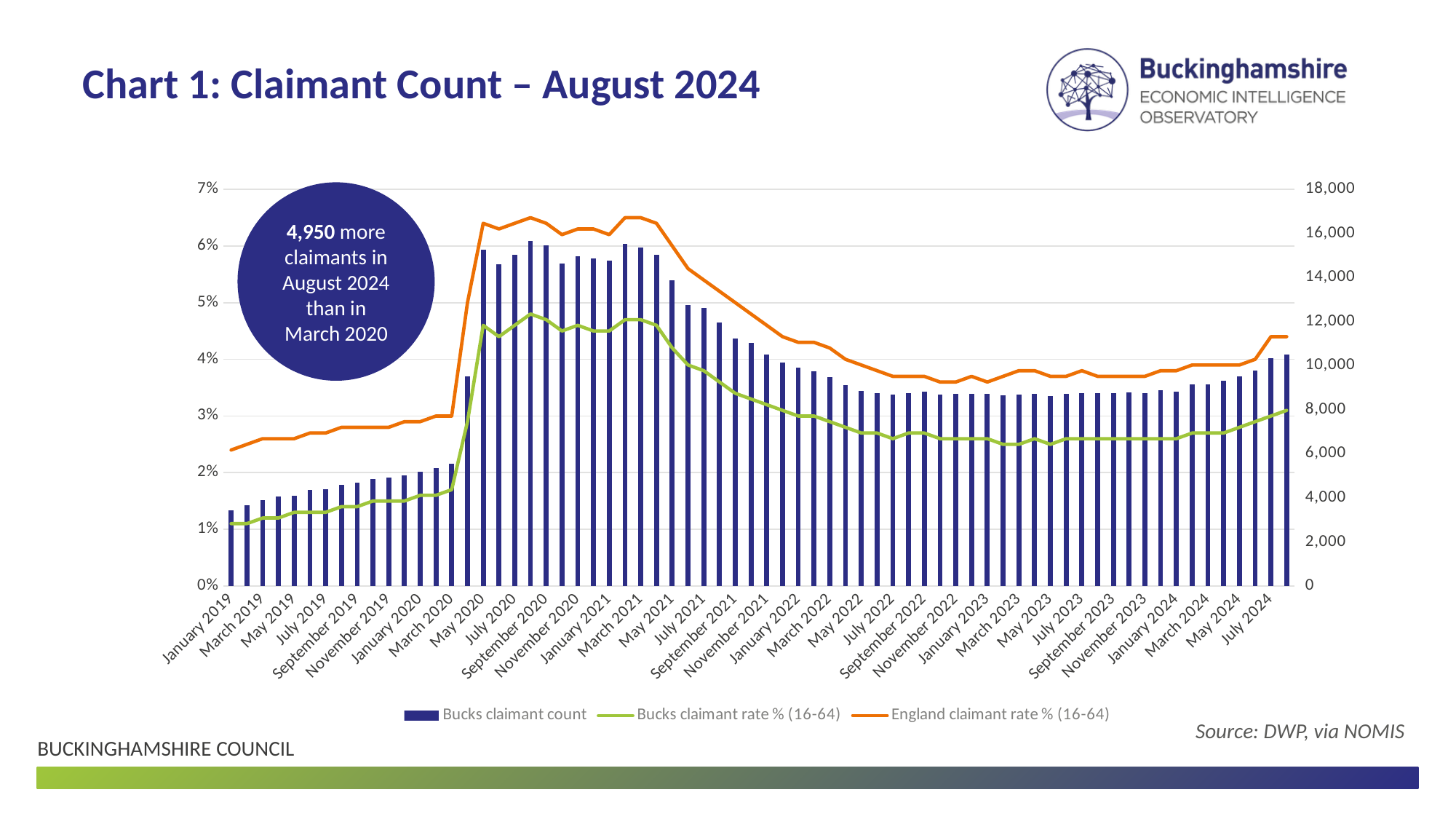
Is the Bucks claimant count for January 2019 greater or less than 4,000? less Is the Bucks claimant count for July 2024 greater or less than 8,000? greater Does the Bucks claimant count rise or fall between May 2021 and July 2022? fall In January 2021, which is higher: the England claimant rate % (16-64) or the Bucks claimant rate % (16-64)? England claimant rate % (16-64) Is the England claimant rate % (16-64) for January 2019 greater or less than 3%? less Does the Bucks claimant count rise or fall between January 2019 and March 2020? rise Which series is plotted as bars? Bucks claimant count How many series does the legend list? 3 According to the callout, how many more claimants were there in August 2024 than in March 2020? 4,950 What kind of chart is shown on the slide? A combined bar and line chart In which month is the Bucks claimant count bar lowest? January 2019